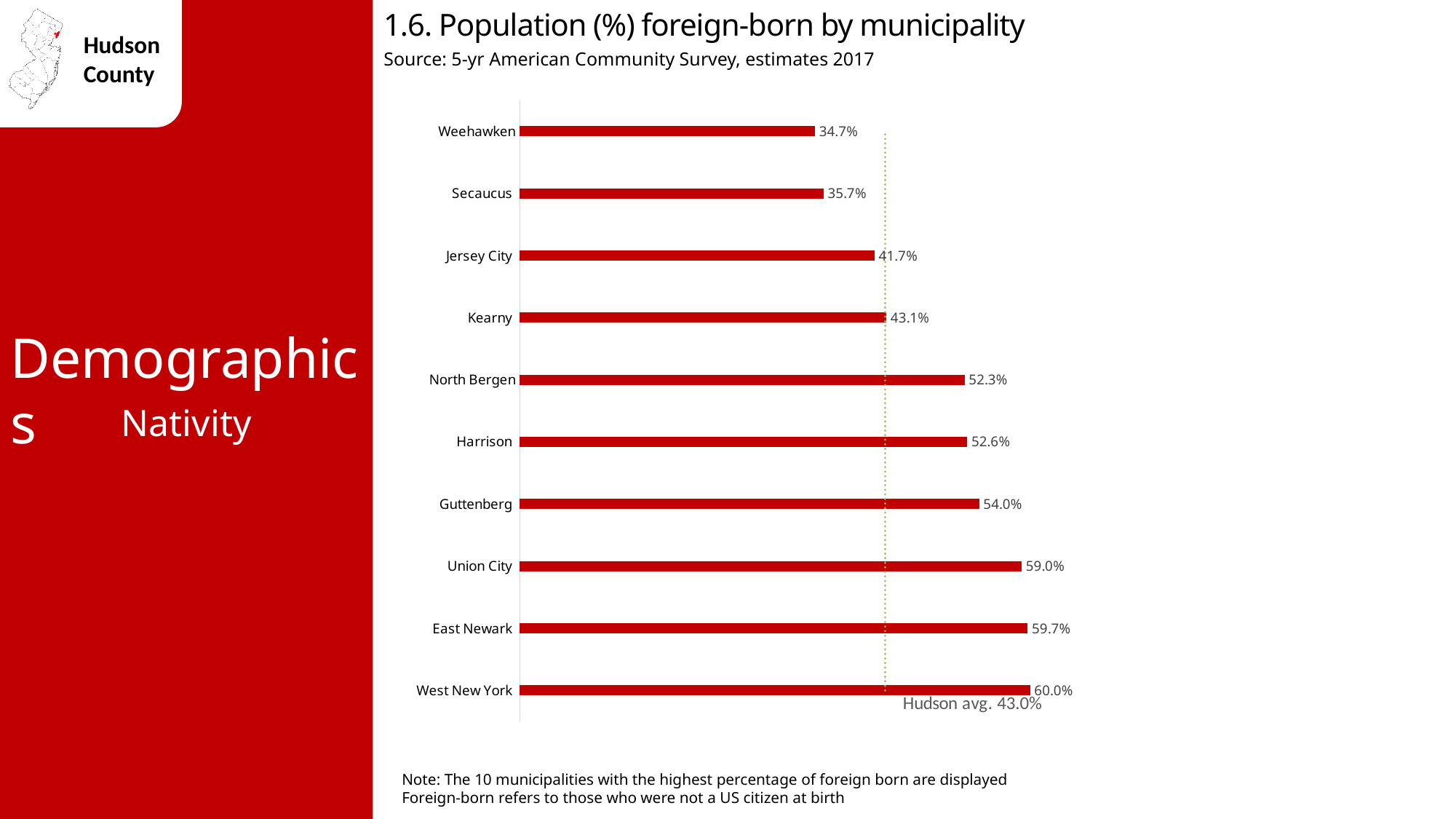
What is the percentage of foreign-born population in Guttenberg? 54.0% Which municipality has the highest percentage of foreign-born population? West New York What is the percentage of foreign-born population in Jersey City? 41.7% What is the source of the data shown in the chart? 5-yr American Community Survey, estimates 2017 What type of chart is used to display the data? Bar chart What is the title of the chart? 1.6. Population (%) foreign-born by municipality What is the difference in percentage points between Union City and Secaucus? 23.3 Which municipality has the lowest percentage of foreign-born population? Weehawken Which has a higher foreign-born percentage, North Bergen or Kearny? North Bergen How many municipalities are shown in the chart? 10 What is the percentage of foreign-born population in East Newark? 59.7% What is the Hudson County average percentage of foreign-born population shown on the chart? 43.0%